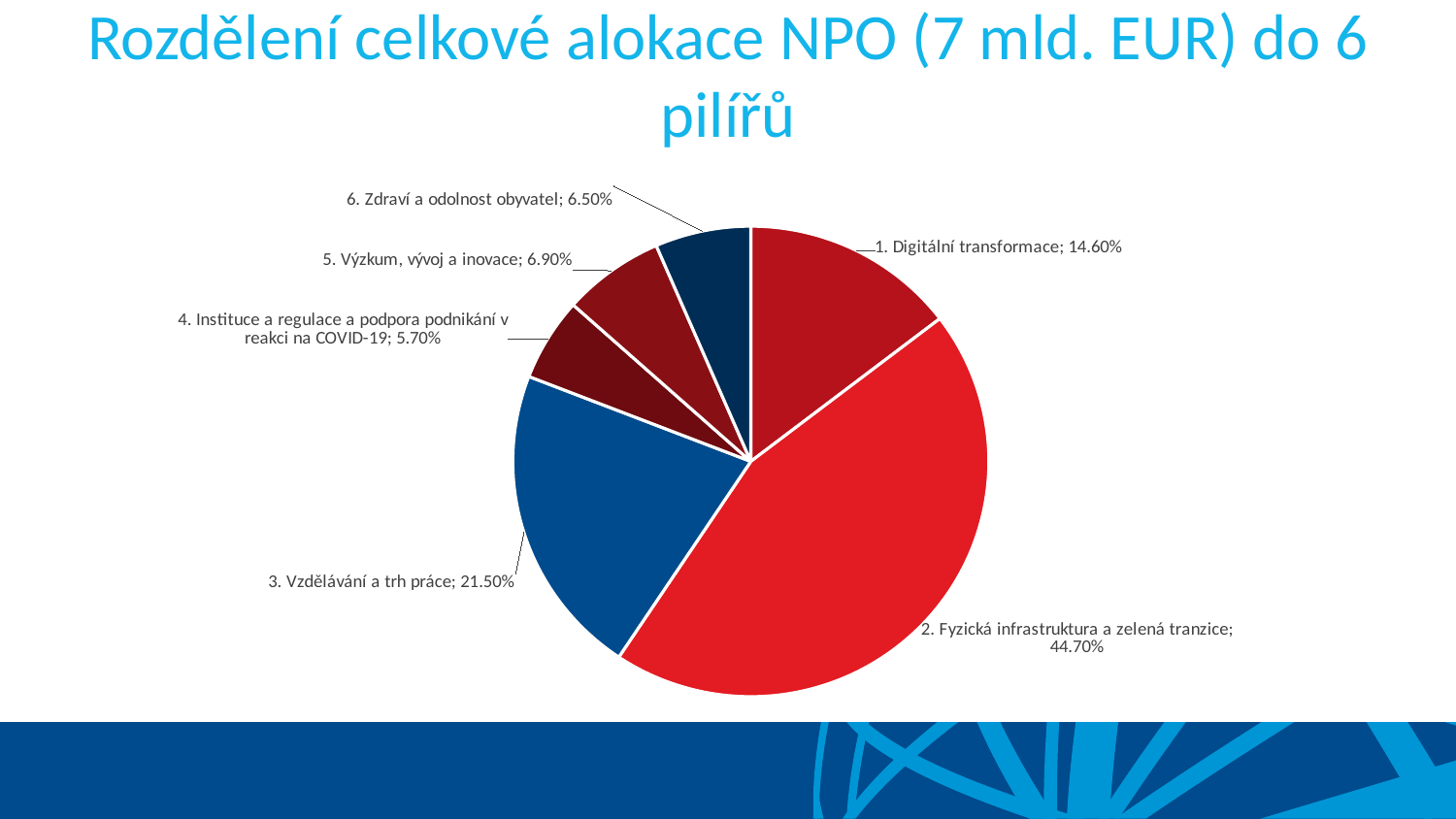
What is the difference in percentage points between "2. Fyzická infrastruktura a zelená tranzice" and "3. Vzdělávání a trh práce"? 23.20 percentage points Which has the larger share: "5. Výzkum, vývoj a inovace" or "6. Zdraví a odolnost obyvatel"? 5. Výzkum, vývoj a inovace What kind of chart is shown on the slide? pie chart What is the value shown for "1. Digitální transformace"? 14.60% What is the difference in percentage points between "1. Digitální transformace" and "5. Výzkum, vývoj a inovace"? 7.70 percentage points Which pillar has the smallest share of the pie? 4. Instituce a regulace a podpora podnikání v reakci na COVID-19 What is the title of the slide? Rozdělení celkové alokace NPO (7 mld. EUR) do 6 pilířů What is the value shown for "4. Instituce a regulace a podpora podnikání v reakci na COVID-19"? 5.70% What share of the pie does "2. Fyzická infrastruktura a zelená tranzice" have? 44.70% How many slices does the pie chart have? 6 Which pillar has the largest share of the pie? 2. Fyzická infrastruktura a zelená tranzice What is the value shown for "3. Vzdělávání a trh práce"? 21.50%